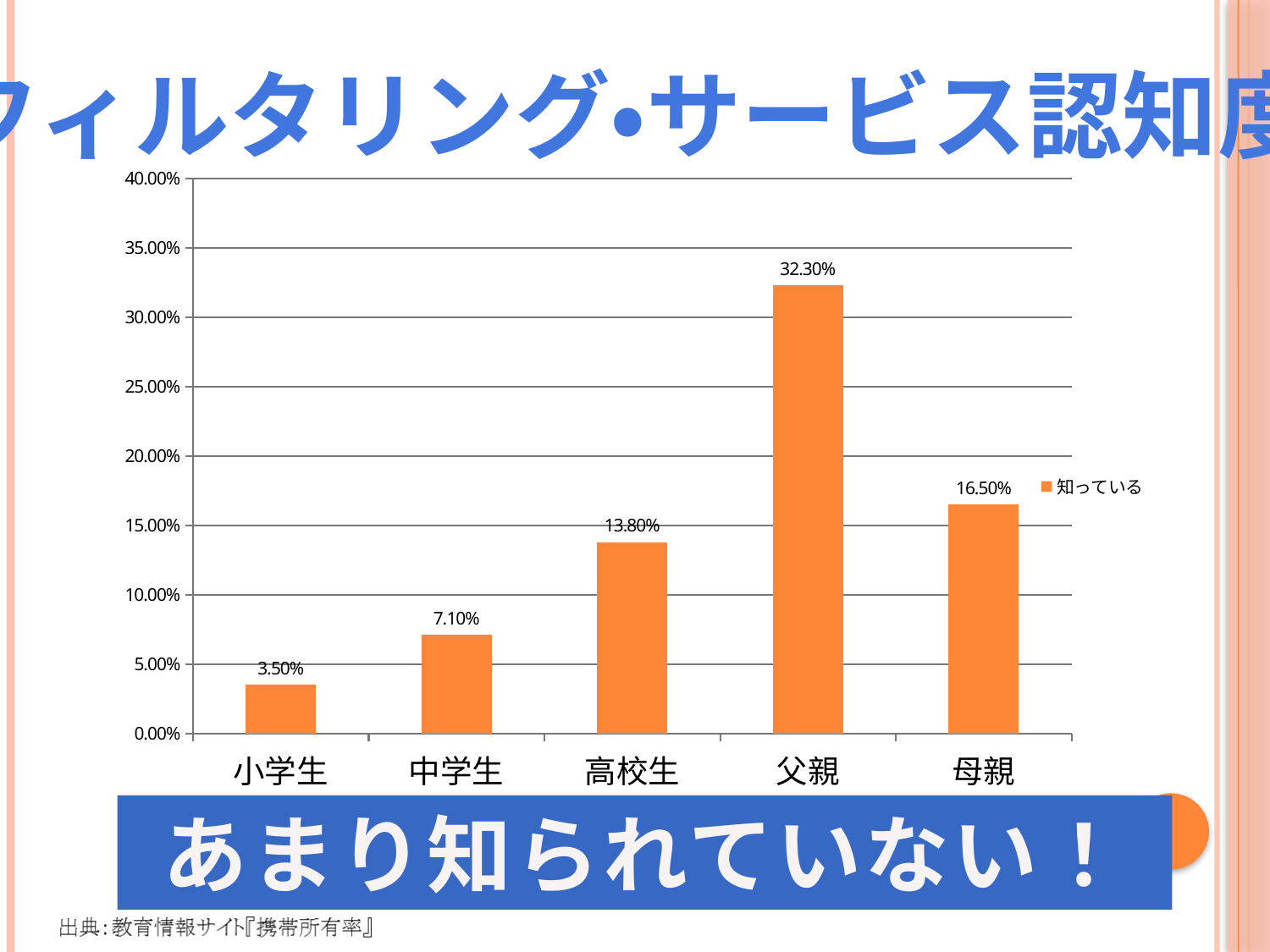
What is the value for 小学生? 3.50% Which category has the lowest value? 小学生 How many categories are shown on the x axis? 5 What is the value for 父親? 32.30% Which is larger, the value for 母親 or the value for 高校生? 母親 What kind of chart is shown on the slide? bar chart What is the value for 高校生? 13.80% What series name does the legend show? 知っている What is the difference between the values for 中学生 and 小学生? 3.60% Which category has the highest value? 父親 Is the value for 父親 greater or less than 30.00%? greater What is the difference between the values for 父親 and 母親? 15.80%